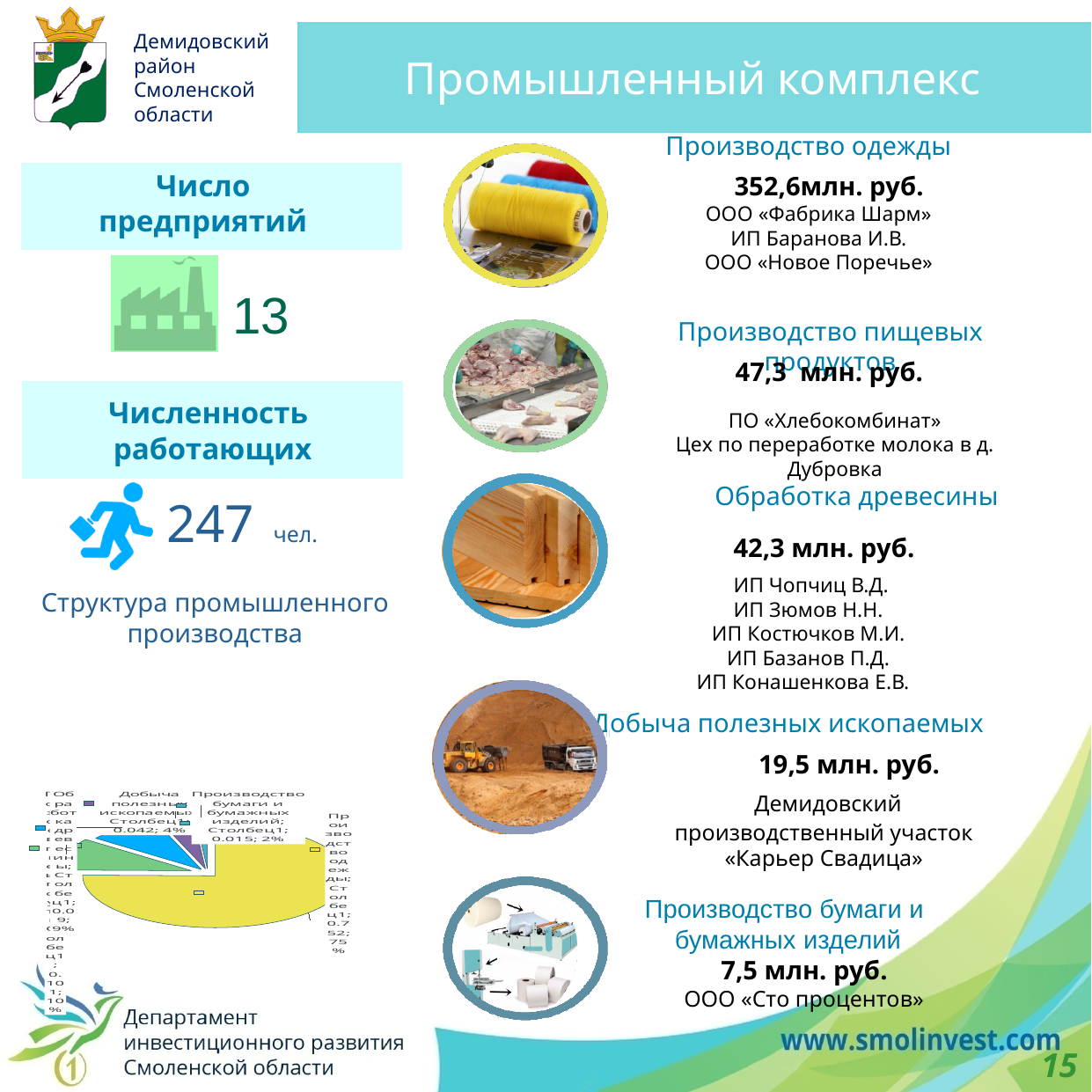
In the pie chart «Структура промышленного производства», which category has the smallest slice? Производство бумаги и бумажных изделий In the pie chart «Структура промышленного производства», which slice is larger: «Добыча полезных ископаемых» or «Производство бумаги и бумажных изделий»? Добыча полезных ископаемых In the pie chart «Структура промышленного производства», what is the difference in percentage points between the «Производство одежды» slice and the «Добыча полезных ископаемых» slice? 71 In the pie chart «Структура промышленного производства», what share is labelled for «Производство одежды»? 75% In the pie chart «Структура промышленного производства», what share is labelled for «Добыча полезных ископаемых»? 4% What is the title of the pie chart on the left side of the slide? Структура промышленного производства What kind of chart is shown under the heading «Структура промышленного производства»? pie chart In the pie chart «Структура промышленного производства», which category has the largest slice? Производство одежды In the pie chart «Структура промышленного производства», what share is labelled for «Производство бумаги и бумажных изделий»? 2% How many slices does the pie chart «Структура промышленного производства» have? 5 In the pie chart «Структура промышленного производства», what colour is the largest slice? yellow